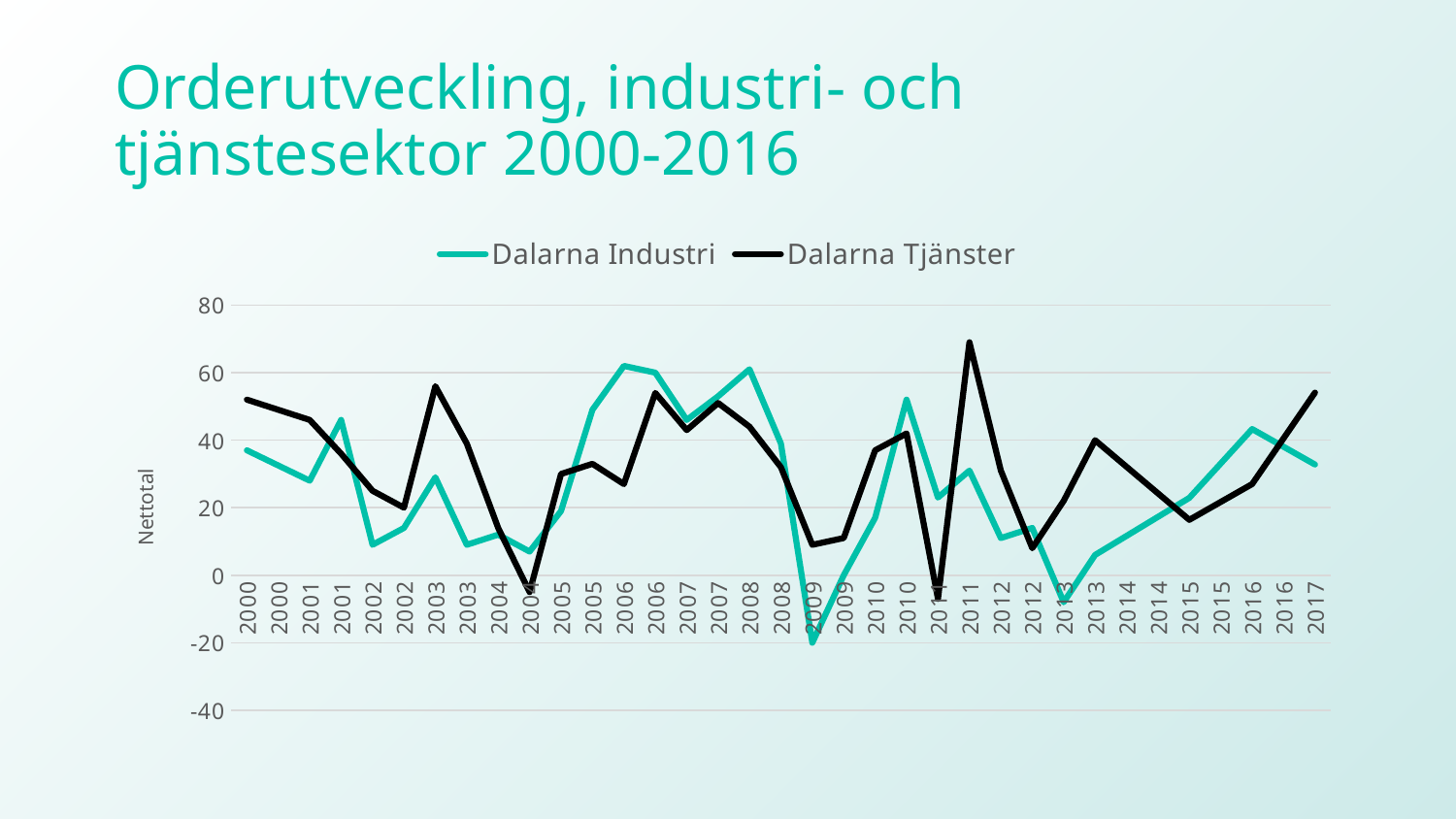
What is the label on the vertical axis? Nettotal How many distinct years are labelled on the x axis? 18 At the first 2003 point, which series has the larger value, Dalarna Industri or Dalarna Tjänster? Dalarna Tjänster Is the value for Dalarna Tjänster at the first 2011 point greater or less than 60? less What are the two series named in the legend? Dalarna Industri and Dalarna Tjänster At which year does Dalarna Tjänster reach its highest value? 2011 Does Dalarna Tjänster rise or fall from the first 2015 point to 2017? rise Is the value for Dalarna Industri at the first 2009 point greater or less than 0? less How many series does the legend list? 2 Is the value for Dalarna Industri at the first 2006 point greater or less than 40? greater At which year does Dalarna Industri reach its lowest value? 2009 What kind of chart is shown on the slide? line chart